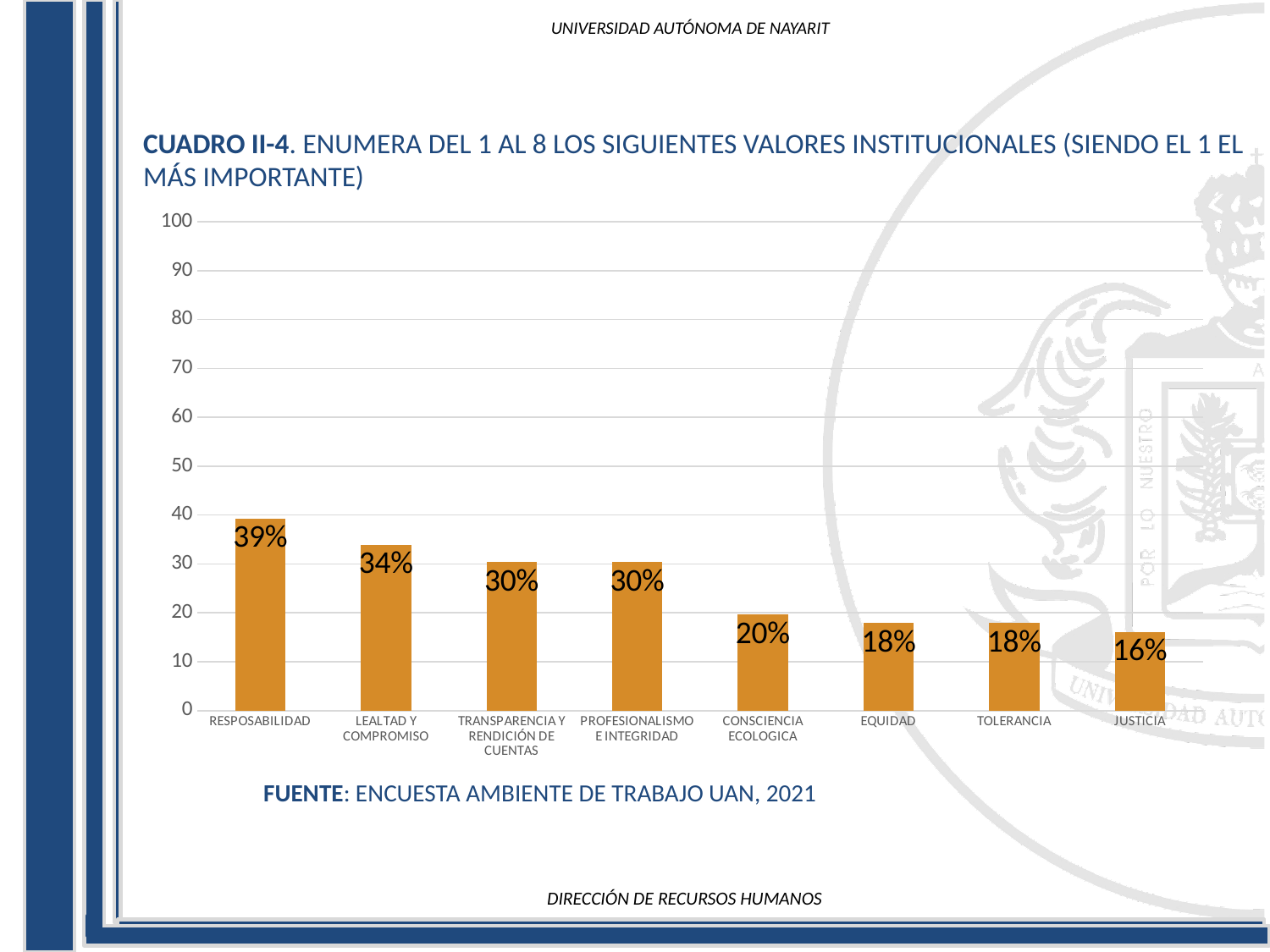
How many categories are shown on the x axis? 8 What is the value for LEALTAD Y COMPROMISO? 34% What source is cited below the chart? ENCUESTA AMBIENTE DE TRABAJO UAN, 2021 What kind of chart is shown on the slide? bar chart Which category has the highest value? RESPOSABILIDAD What is the value for JUSTICIA? 16% Is the value for PROFESIONALISMO E INTEGRIDAD greater or less than 50? less Which category has the lowest value? JUSTICIA What is the value for CONSCIENCIA ECOLOGICA? 20% What is the value for RESPOSABILIDAD? 39% Which is larger, the value for CONSCIENCIA ECOLOGICA or the value for EQUIDAD? CONSCIENCIA ECOLOGICA What is the difference between the values for RESPOSABILIDAD and LEALTAD Y COMPROMISO? 5%